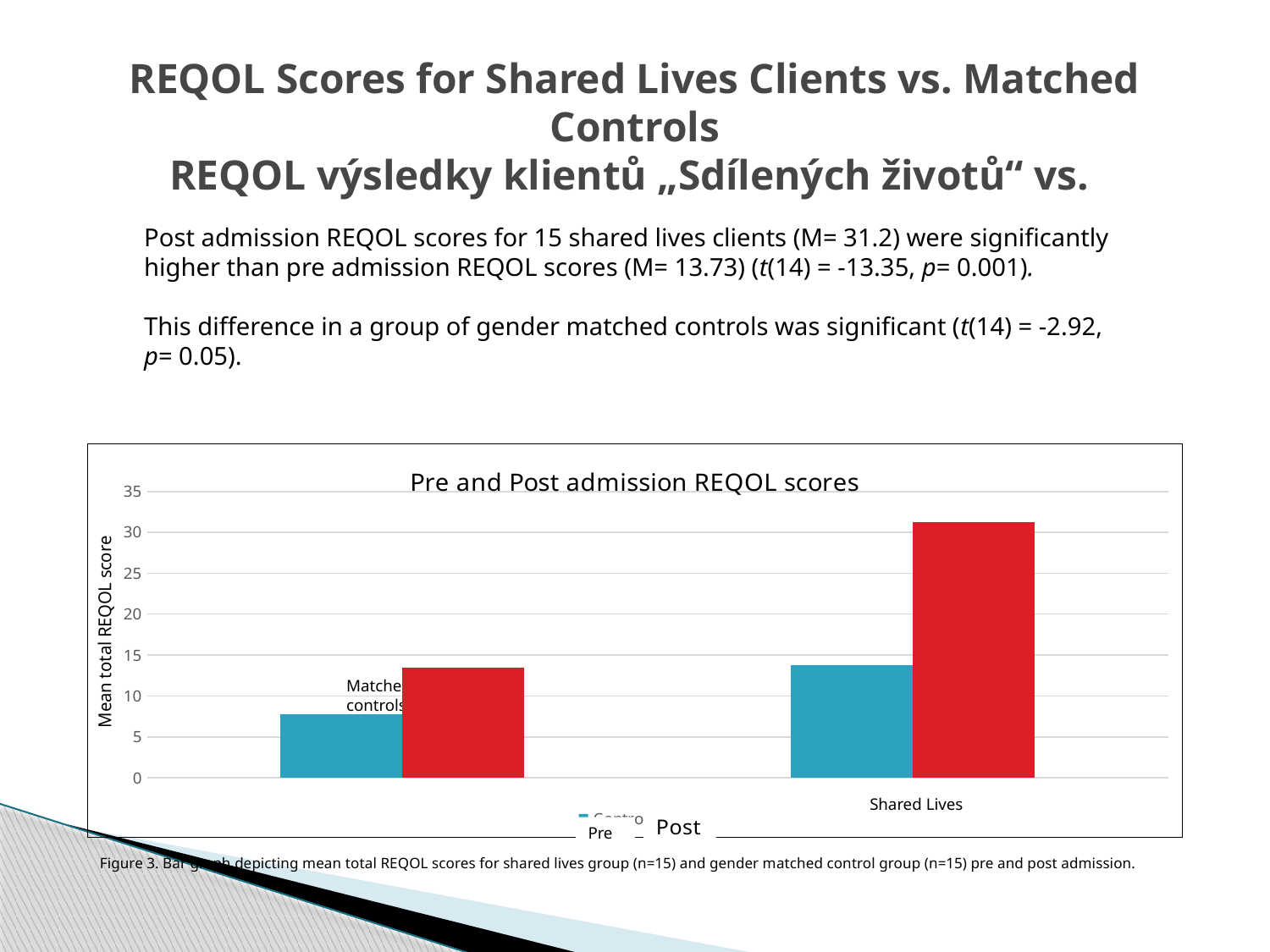
Which bar in the chart is the lowest? Matched controls, Pre Is the Post admission value for Shared Lives greater or less than 25? greater For the Shared Lives group, is the Post admission score higher or lower than the Pre admission score? higher Which bar in the chart is the highest? Shared Lives, Post How many groups (categories) are shown on the x axis of the chart? 2 Is the Pre admission value for Matched controls greater or less than 10? less Which group has the larger Post admission REQOL score, Matched controls or Shared Lives? Shared Lives What is the label on the vertical axis of the chart? Mean total REQOL score How many series does the chart's legend list? 2 What is the title of the chart? Pre and Post admission REQOL scores Is the Pre admission value for Shared Lives greater or less than 15? less What type of chart is shown on the slide? Bar chart